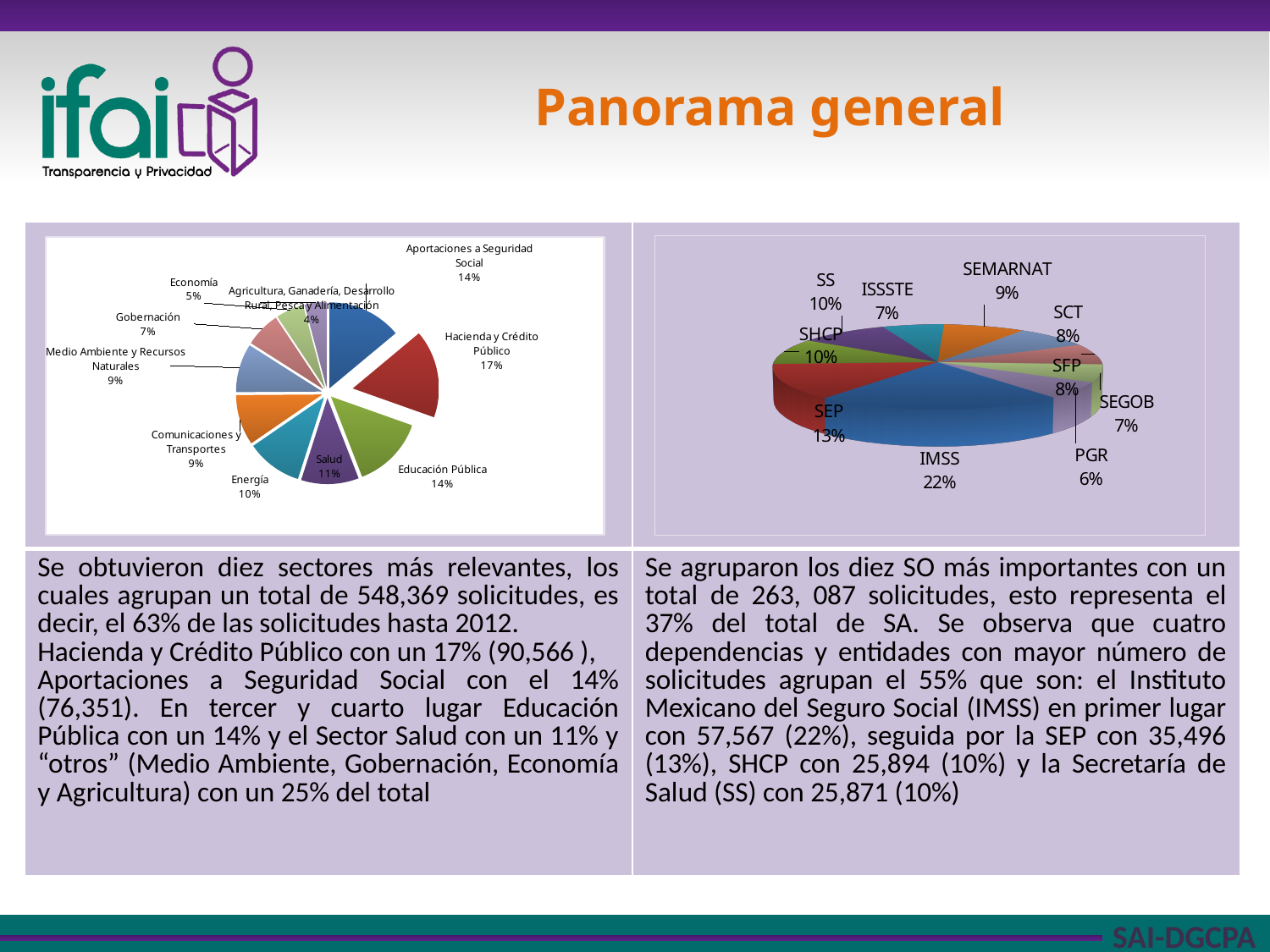
In the left pie chart, which sector has the largest slice? Hacienda y Crédito Público In the right pie chart, how many slices are there? 10 In the right pie chart, which is larger, SEP or SEMARNAT? SEP In the right pie chart, what is the difference in percentage points between IMSS and SEP? 9 In the right pie chart, which entity has the smallest slice? PGR In the right pie chart, what share does IMSS have? 22% In the left pie chart, which sector has the smallest slice? Agricultura, Ganadería, Desarrollo Rural, Pesca y Alimentación In the left pie chart, how many slices are there? 10 In the left pie chart, what is the difference in percentage points between Salud and Economía? 6 In the left pie chart, what share does Energía have? 10% In the left pie chart, what share does Hacienda y Crédito Público have? 17% What type of chart is shown on the right side of the slide? Pie chart